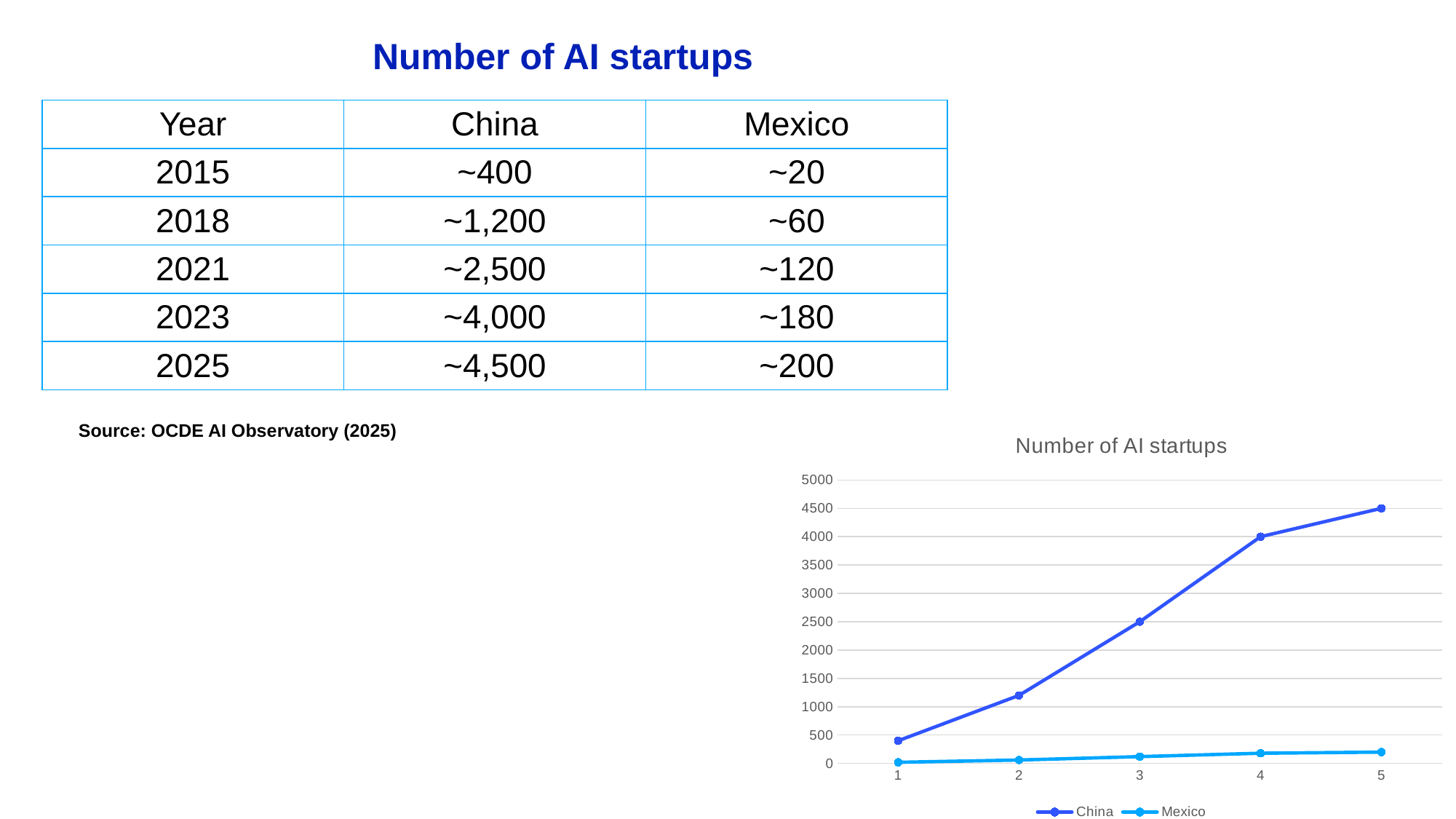
Which series in the chart is drawn in the lighter blue line? Mexico How many series does the chart's legend list? 2 How many points are plotted along the x axis for each series in the chart? 5 In the chart, is the value for Mexico at x = 5 greater or less than 500? less What kind of chart is shown on the slide? line chart In the chart, at which x value is the China series lowest? 1 In the chart, what is the value for China at x = 5? 4500 In the chart, is the value for China at x = 2 greater or less than 1000? greater In the chart, what is the value for China at x = 4? 4000 In the chart, what is the value for China at x = 3? 2500 In the chart, at which x value is the China series highest? 5 What is the title of the chart? Number of AI startups